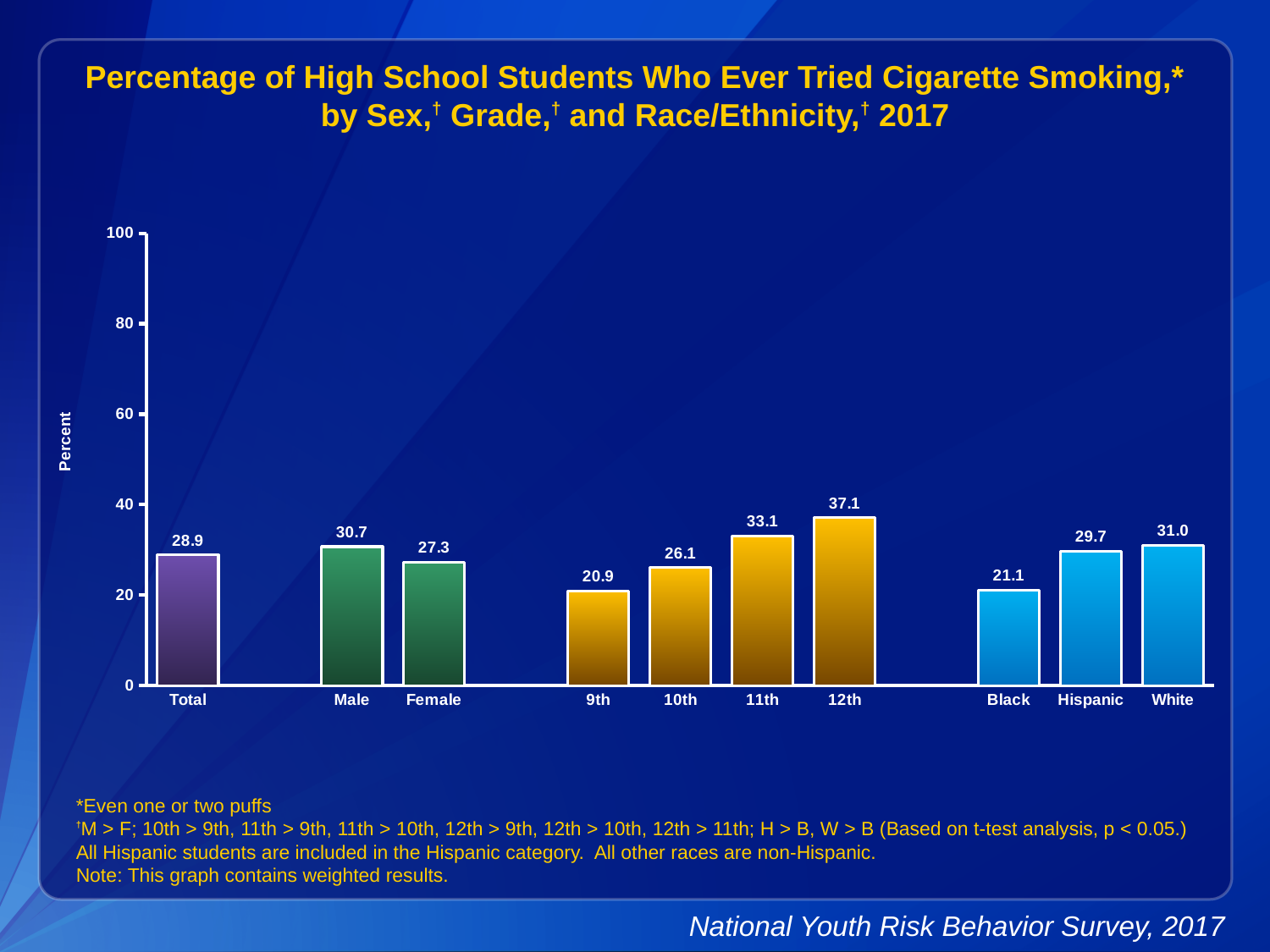
What is the difference between the values for White and Black? 9.9 What is the difference between the values for Male and Female? 3.4 Do the values rise or fall from 9th grade to 12th grade? rise What is the value for Total? 28.9 What is the value for 11th grade? 33.1 Which category has the lowest value? 9th What is the value for Hispanic? 29.7 What is the value for Female? 27.3 Which category has the highest value? 12th Which is larger, the value for 10th grade or the value for Black? 10th What kind of chart is this? bar chart How many bars are shown in the chart? 10